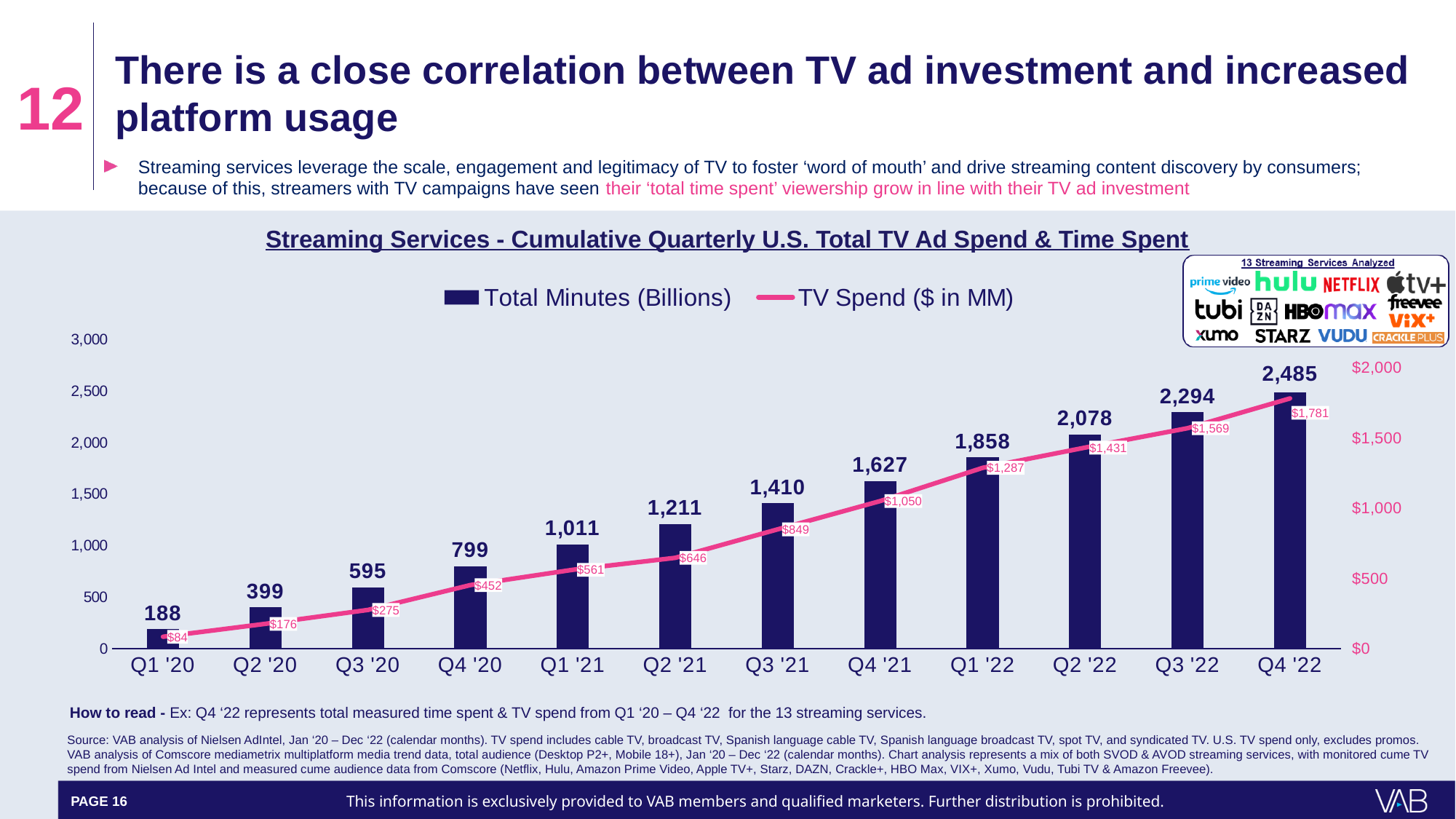
How many quarters are shown on the x axis? 12 Which is larger, the Total Minutes (Billions) value for Q3 '21 or for Q2 '21? Q3 '21 What is the Total Minutes (Billions) value for Q1 '20? 188 Do the Total Minutes (Billions) values rise or fall from Q1 '20 to Q4 '22? rise What is the TV Spend ($ in MM) value for Q2 '21? $646 What is the difference in TV Spend ($ in MM) between Q1 '22 and Q4 '21? $237 Which quarter has the lowest TV Spend ($ in MM) value? Q1 '20 What is the difference in Total Minutes (Billions) between Q4 '22 and Q3 '22? 191 What is the Total Minutes (Billions) value for Q4 '21? 1,627 What is the TV Spend ($ in MM) value for Q4 '22? $1,781 How many series does the legend list? 2 Which quarter has the highest Total Minutes (Billions) value? Q4 '22